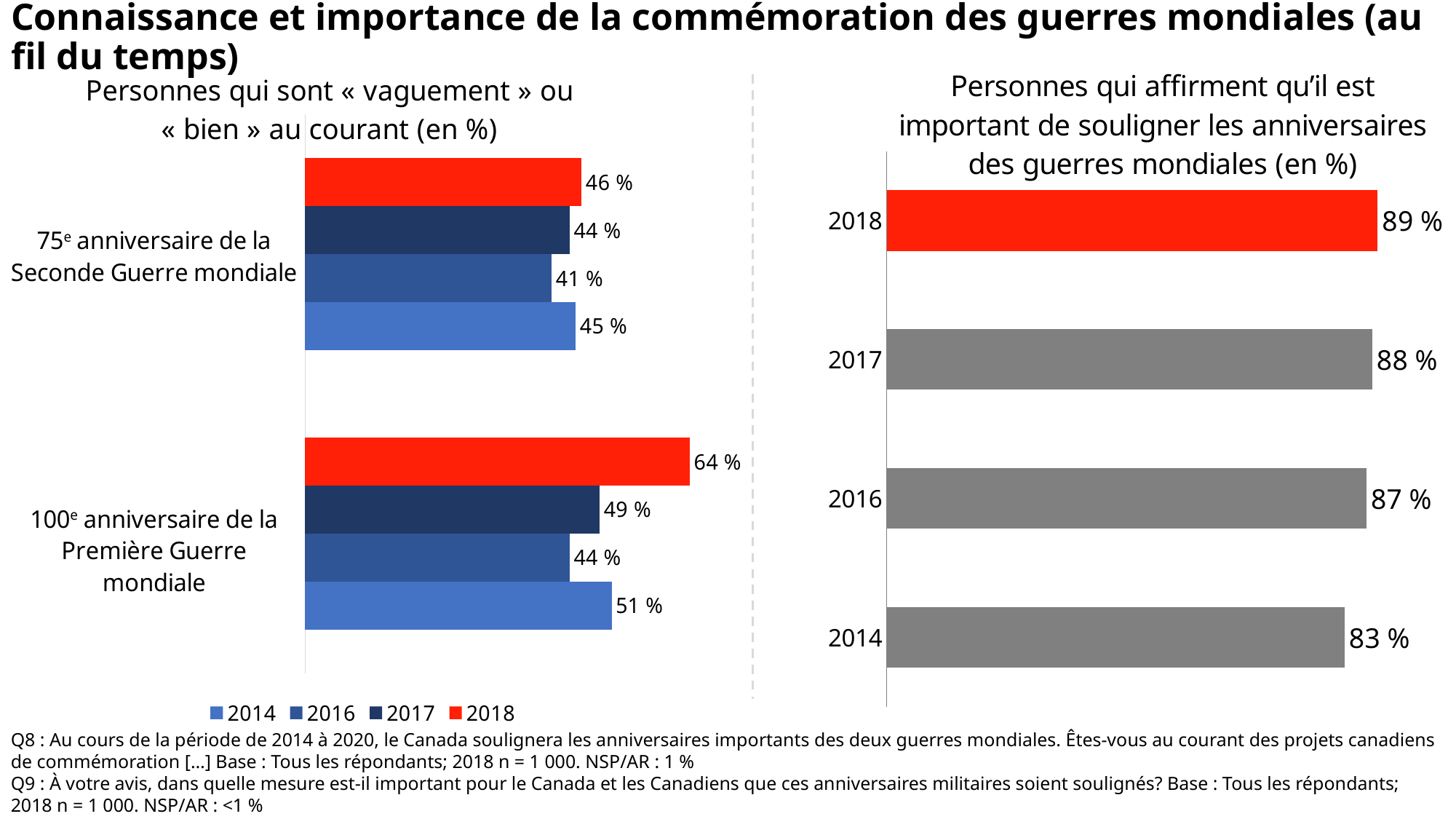
In the right chart, what is the value for 2014? 83 % In the left chart, what is the 2018 value for the 100e anniversaire de la Première Guerre mondiale? 64 % In the left chart, what is the 2016 value for the 75e anniversaire de la Seconde Guerre mondiale? 41 % In the left chart, which is larger for 2014: the 75e anniversaire de la Seconde Guerre mondiale or the 100e anniversaire de la Première Guerre mondiale? 100e anniversaire de la Première Guerre mondiale How many years are shown in the right chart? 4 In the right chart, do the values rise or fall from 2014 to 2018? Rise What kind of chart is the right chart? Bar chart In the right chart, what is the difference between the 2018 and 2014 values? 6 % In the right chart, which year has the highest value? 2018 In the left chart, what is the difference between the 2018 and 2017 values for the 100e anniversaire de la Première Guerre mondiale? 15 % How many series does the legend of the left chart list? 4 In the left chart, which year has the lowest value for the 75e anniversaire de la Seconde Guerre mondiale? 2016